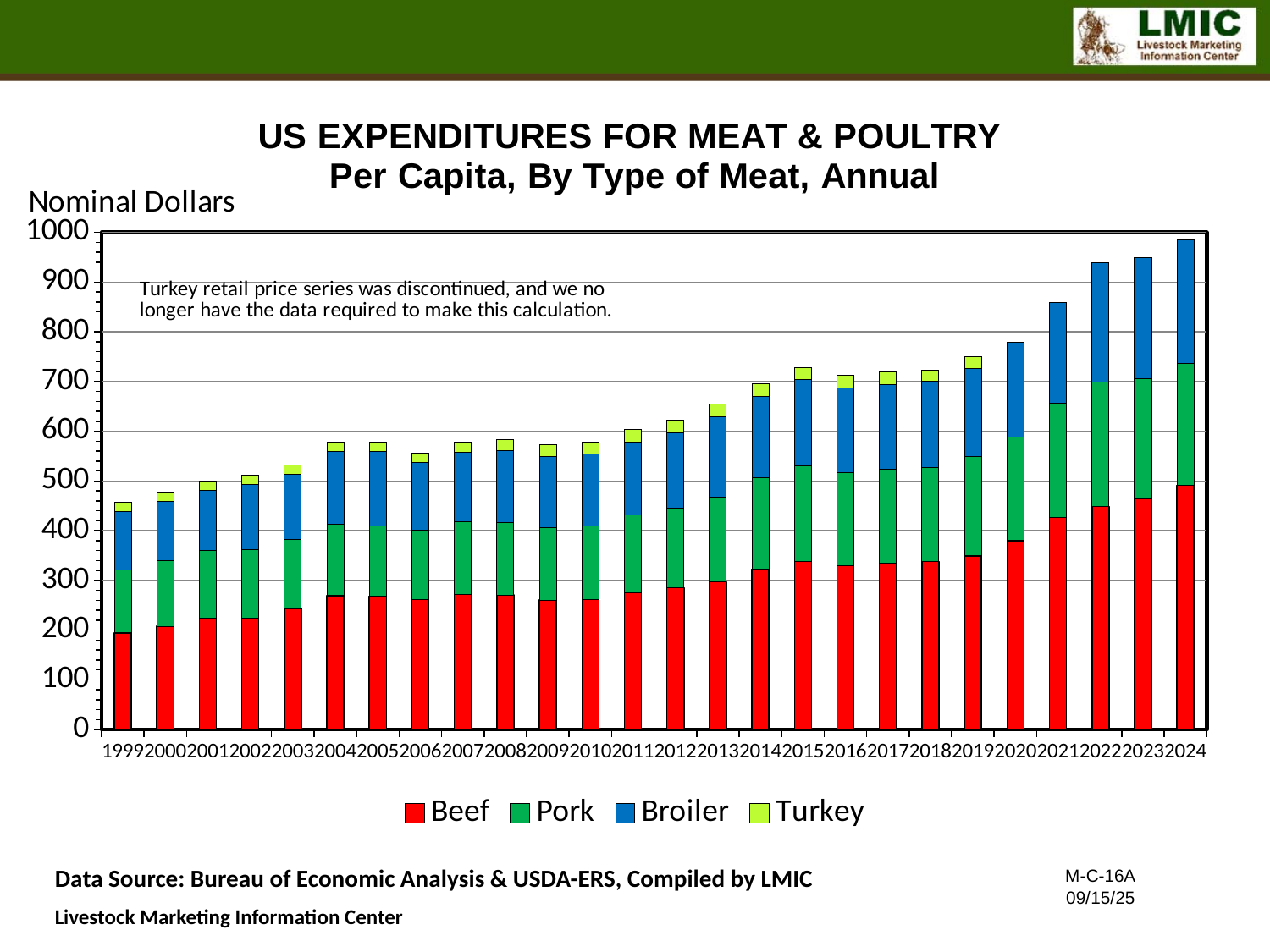
Do total expenditures generally rise or fall from 1999 to 2024? rise How many series does the legend list? 4 Is the total expenditure for 2024 greater or less than 900? greater Which colour represents Beef in the legend? red Which year has the highest total per capita expenditure? 2024 Which year has the larger total expenditure, 2020 or 2021? 2021 Is the Beef value for 2024 greater or less than 400? greater Is the total expenditure for 2021 greater or less than 800? greater How many years are shown along the x axis? 26 What kind of chart is shown on the slide? stacked bar chart Which year has the lowest total per capita expenditure? 1999